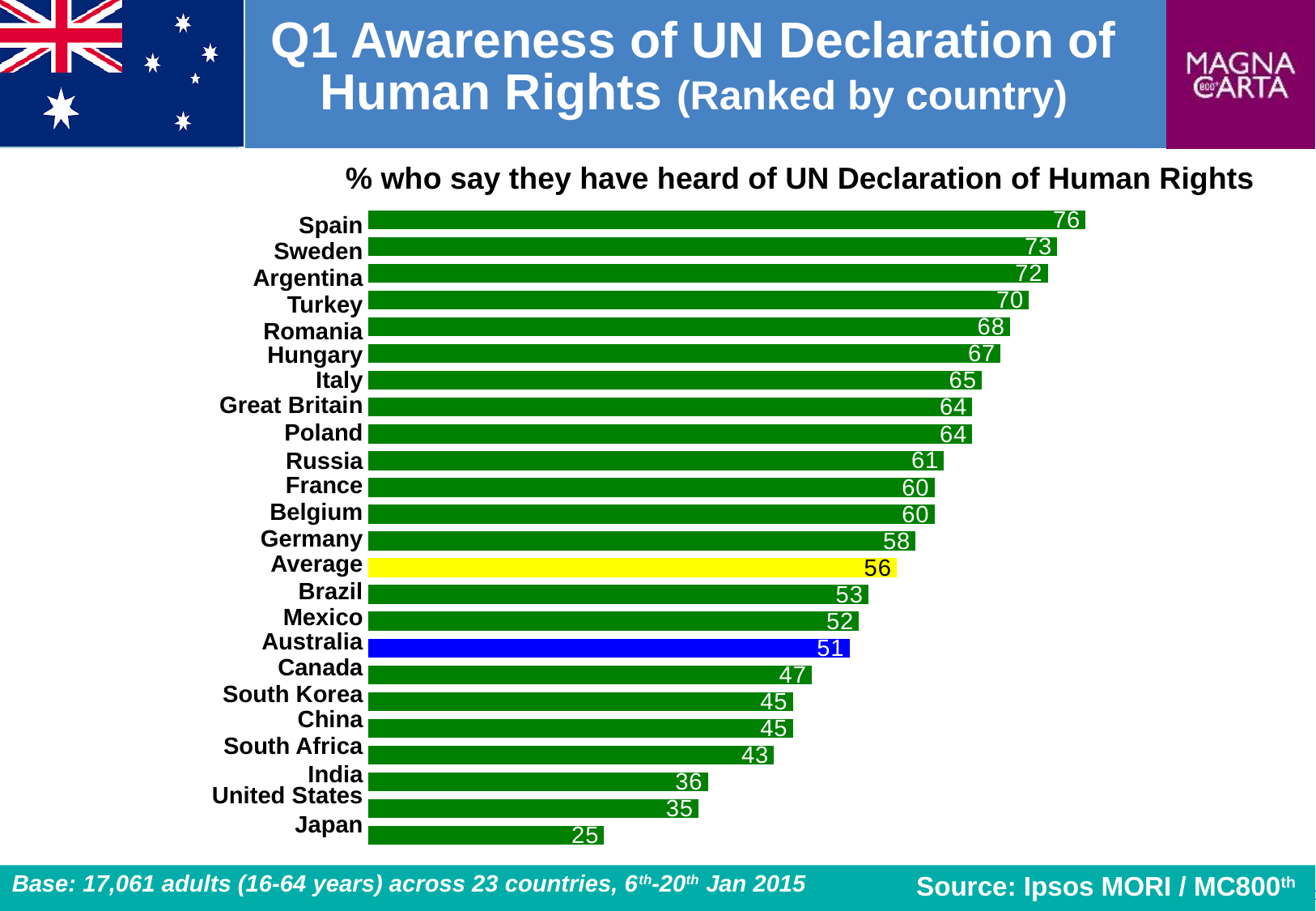
What is the value shown for the Average bar? 56 Which has a larger value, India or United States? India What is the value for Australia? 51 Which has a larger value, Canada or Mexico? Mexico How many countries are shown in the chart (excluding the Average bar)? 23 What is the value for Spain? 76 Which country has the lowest value? Japan What colour is the bar for Australia? Blue What is the difference between the values for Australia and the Average? 5 What kind of chart is shown on the slide? Bar chart Which country has the highest value? Spain What is the difference between the values for Spain and Japan? 51